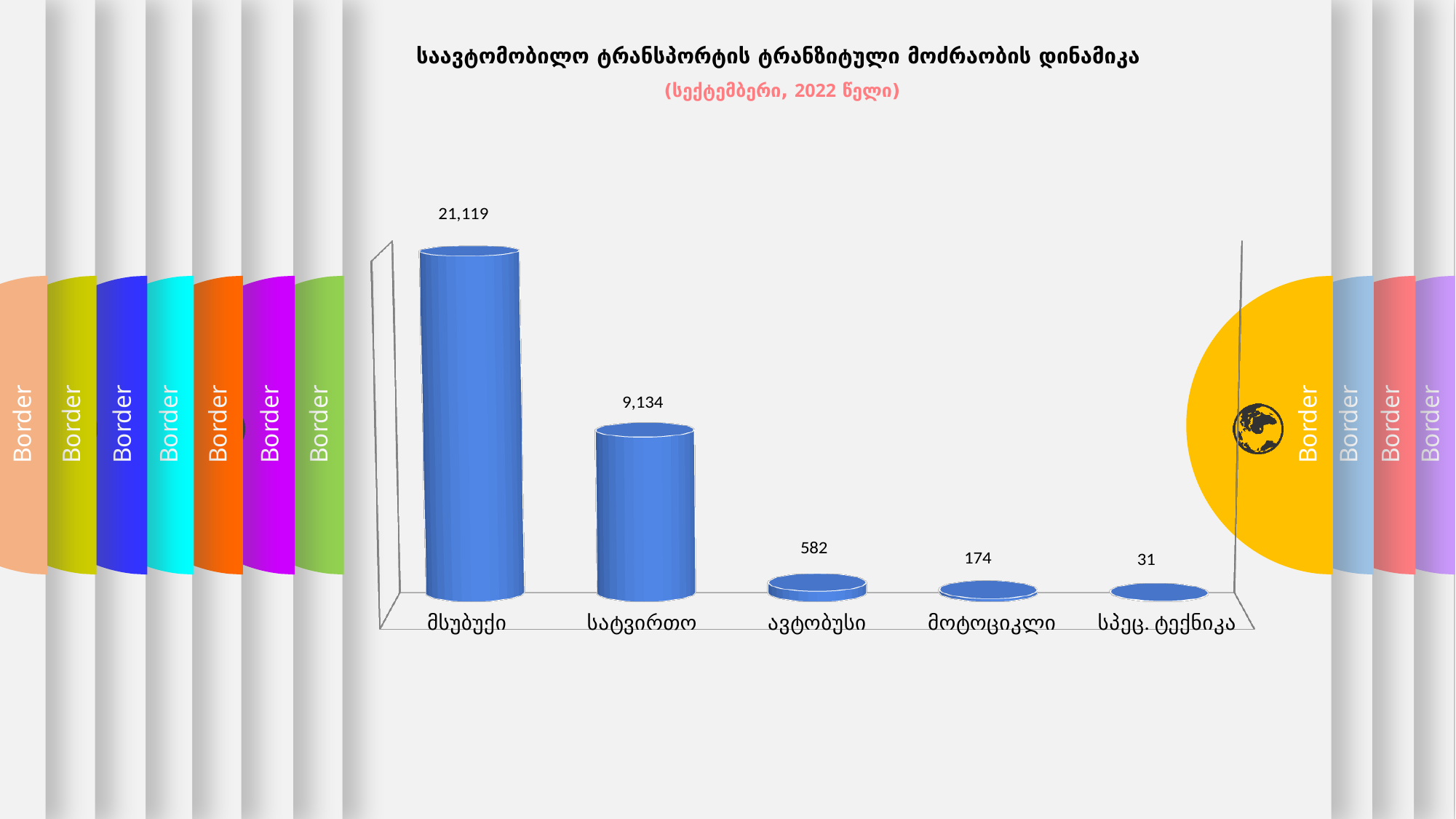
Which category has the highest value? მსუბუქი How many categories are shown in the chart? 5 What is the value for ავტობუსი? 582 What kind of chart is shown on the slide? Bar chart What is the value for მოტოციკლი? 174 Which is larger, the value for ავტობუსი or the value for მოტოციკლი? ავტობუსი What is the value for სპეც. ტექნიკა? 31 Which category has the lowest value? სპეც. ტექნიკა What is the difference between the values for მსუბუქი and სატვირთო? 11,985 What is the value for სატვირთო? 9,134 What is the value for მსუბუქი? 21,119 What period is given in the chart's subtitle? სექტემბერი, 2022 წელი